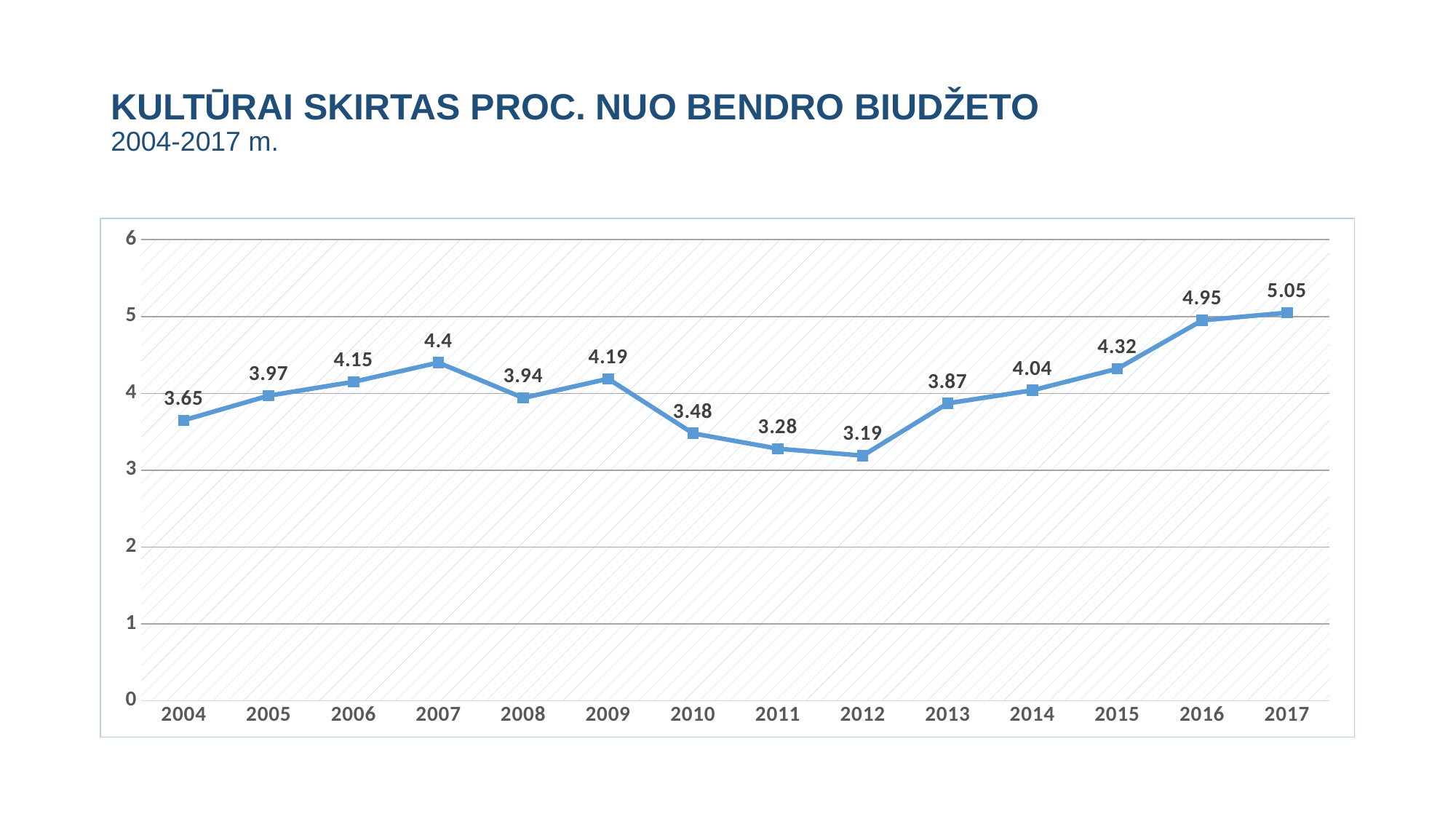
What is the value for 2004? 3.65 Which year has the highest value? 2017 What kind of chart is shown on the slide? line chart Which year has the lowest value? 2012 How many years are plotted on the chart? 14 What is the difference between the values for 2017 and 2012? 1.86 What is the value for 2016? 4.95 What is the difference between the values for 2007 and 2008? 0.46 Do the values rise or fall from 2012 to 2017? rise What is the value for 2012? 3.19 Which is larger, the value for 2009 or the value for 2010? 2009 Is the value for 2015 greater or less than 4? greater